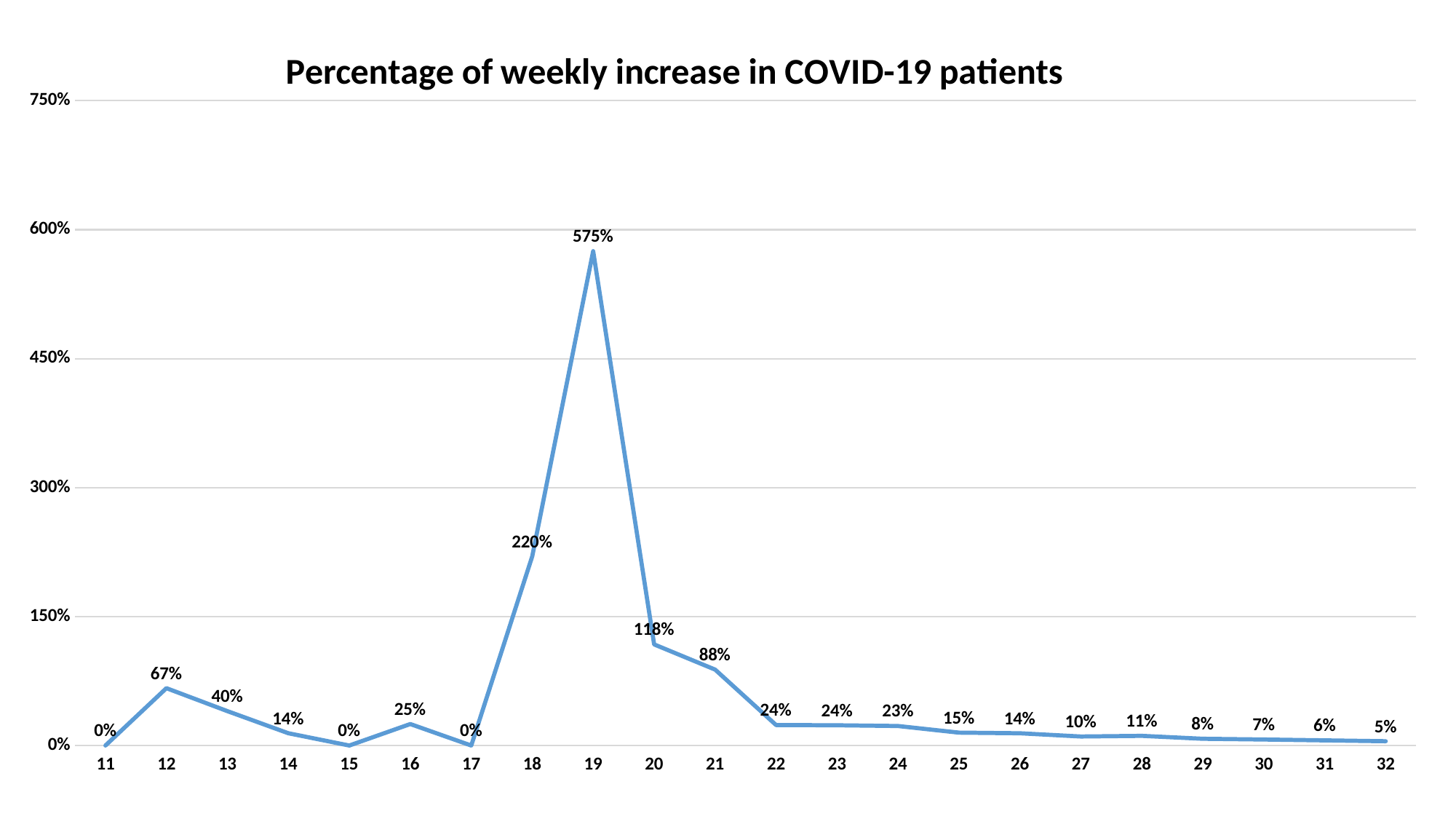
Which week has the highest percentage of weekly increase? 19 What is the percentage of weekly increase at week 19? 575% What is the difference between the values at week 19 and week 20? 457% What is the percentage of weekly increase at week 12? 67% What is the percentage of weekly increase at week 32? 5% What is the title of the chart? Percentage of weekly increase in COVID-19 patients What is the difference between the values at week 20 and week 21? 30% Is the value at week 18 greater or less than 150%? greater Which is larger, the value at week 13 or the value at week 16? week 13 What kind of chart is shown? line chart What is the percentage of weekly increase at week 18? 220% How many weeks are plotted on the x axis? 22